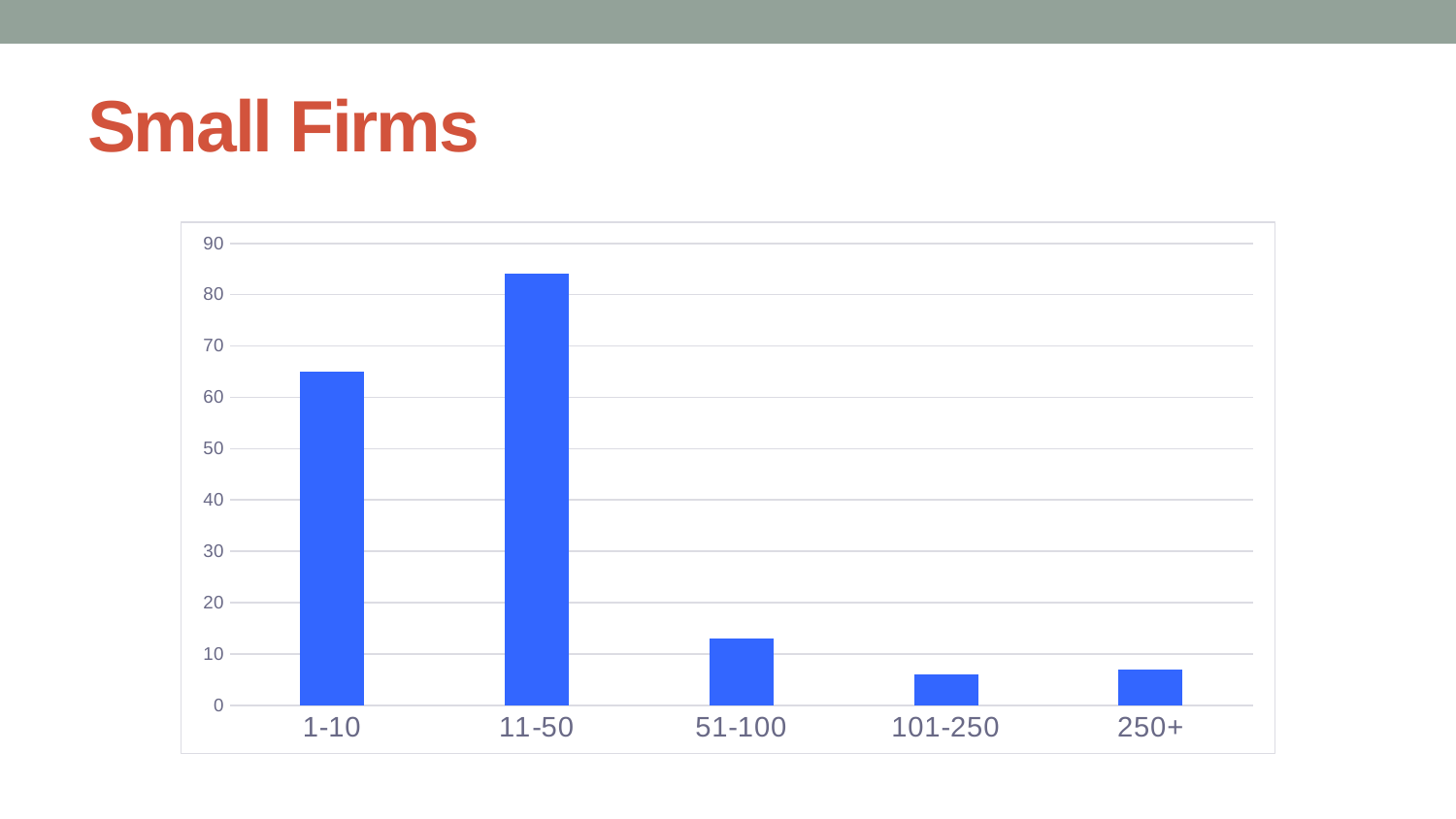
Is the value for 51-100 greater or less than 10? greater What kind of chart is shown on the slide? bar chart Is the value for 1-10 greater or less than 60? greater How many categories are shown on the x axis of the chart? 5 Is the value for 250+ greater or less than 10? less Which has the larger value, 51-100 or 250+? 51-100 Does the value rise or fall from 11-50 to 51-100? fall Which category has the highest value in the chart? 11-50 Which has the larger value, 1-10 or 11-50? 11-50 What is the title of the slide containing the chart? Small Firms